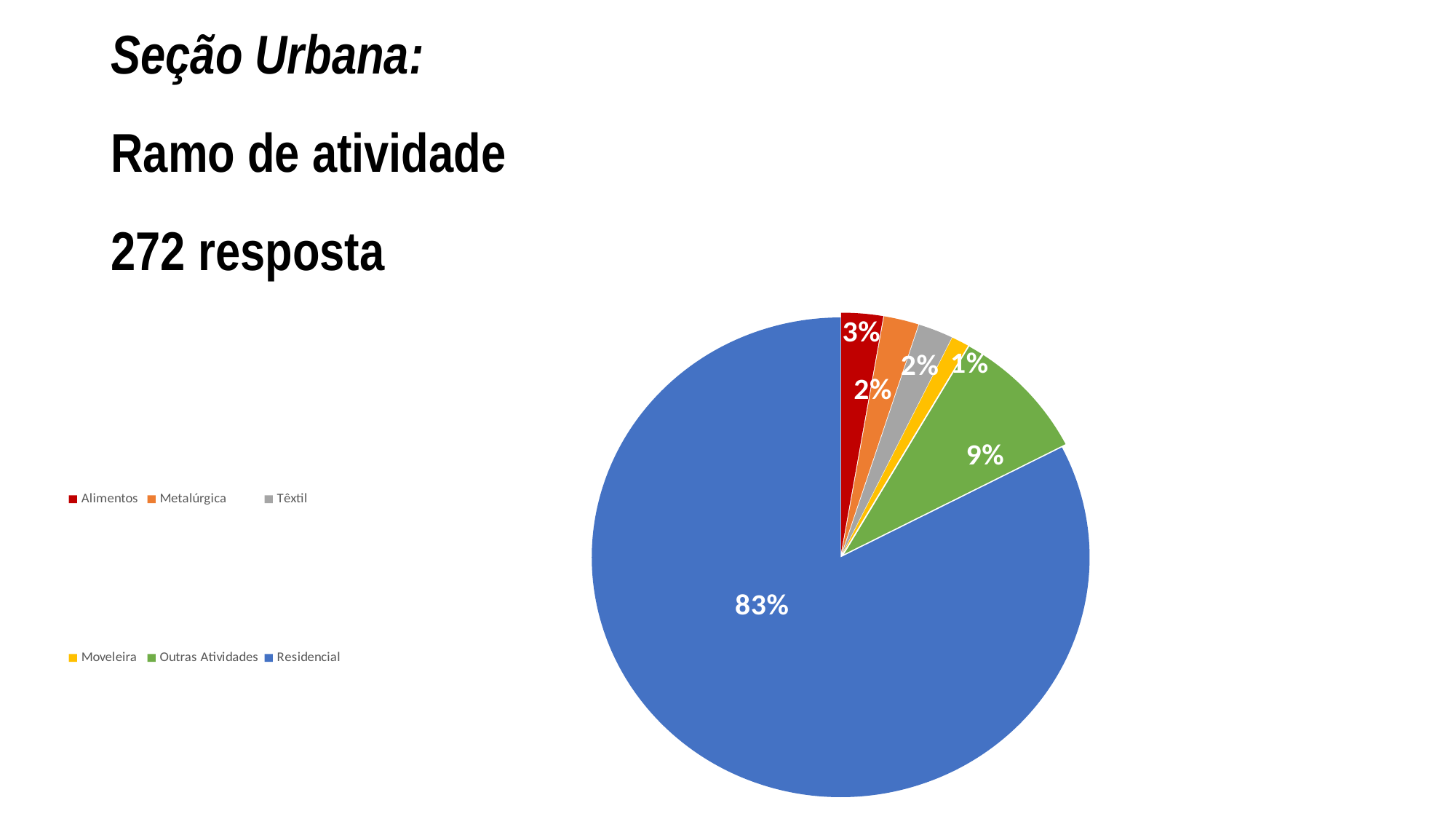
What share of the pie does Alimentos represent? 3% Which is larger, the slice for Alimentos or the slice for Têxtil? Alimentos What share of the pie does Outras Atividades represent? 9% Which category has the largest slice of the pie? Residencial Which category has the smallest slice of the pie? Moveleira What colour is the Residencial slice? blue What kind of chart is shown on the slide? pie chart What is the difference in percentage points between Residencial and Outras Atividades? 74 What share of the pie does Moveleira represent? 1% What share of the pie does Residencial represent? 83% What share of the pie does Metalúrgica represent? 2% How many categories does the legend list? 6